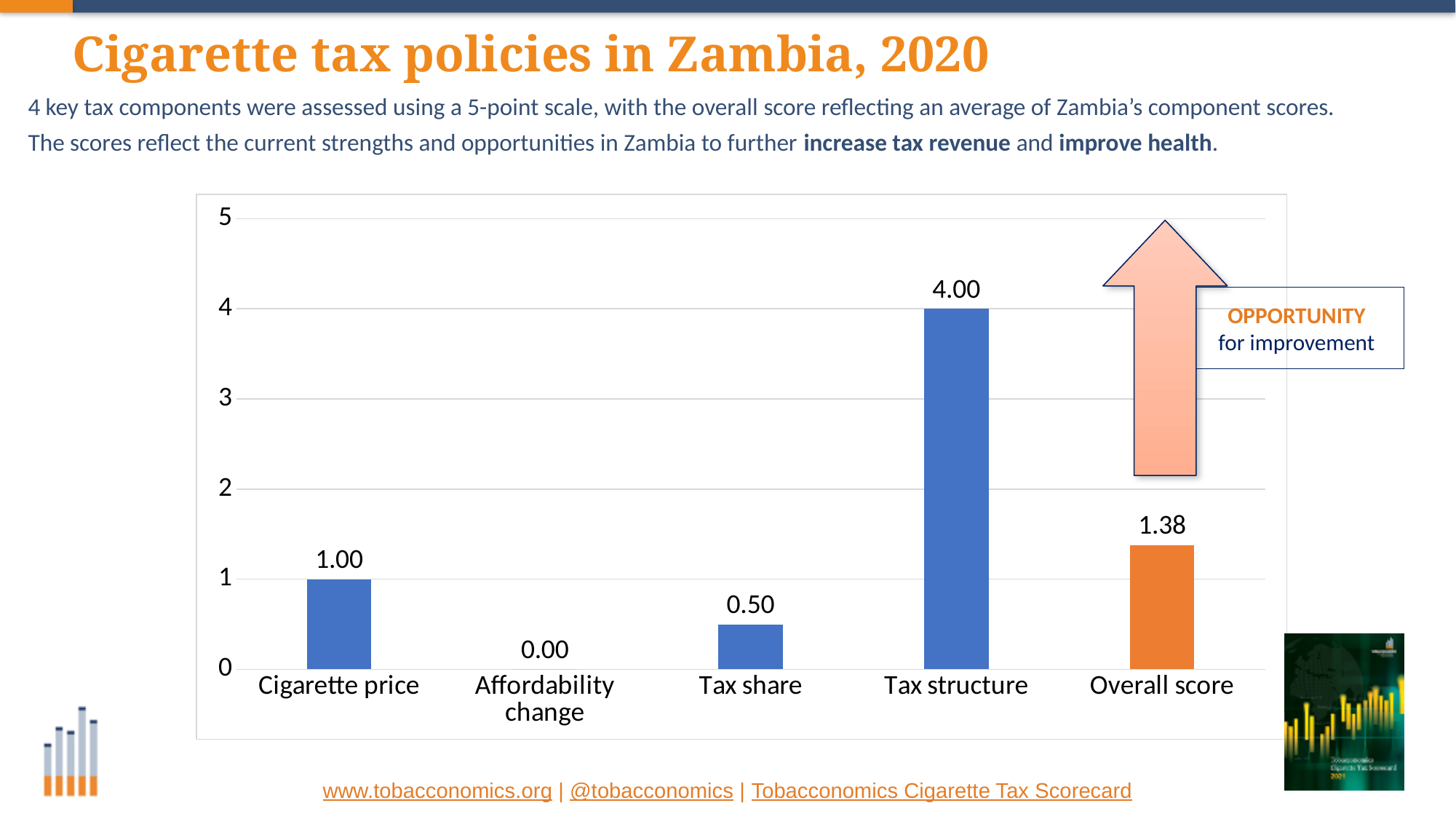
What is the value for Affordability change? 0.00 What is the difference between the values for Tax structure and Tax share? 3.50 What kind of chart is shown on the slide? bar chart Which category has the highest value? Tax structure Which is larger, the value for Cigarette price or the value for Tax share? Cigarette price Which category has the lowest value? Affordability change How many categories are shown on the x axis? 5 What is the Overall score? 1.38 Which bar is coloured orange rather than blue? Overall score What is the value for Tax structure? 4.00 Is the value for Overall score greater or less than 2? less What is the value for Cigarette price? 1.00